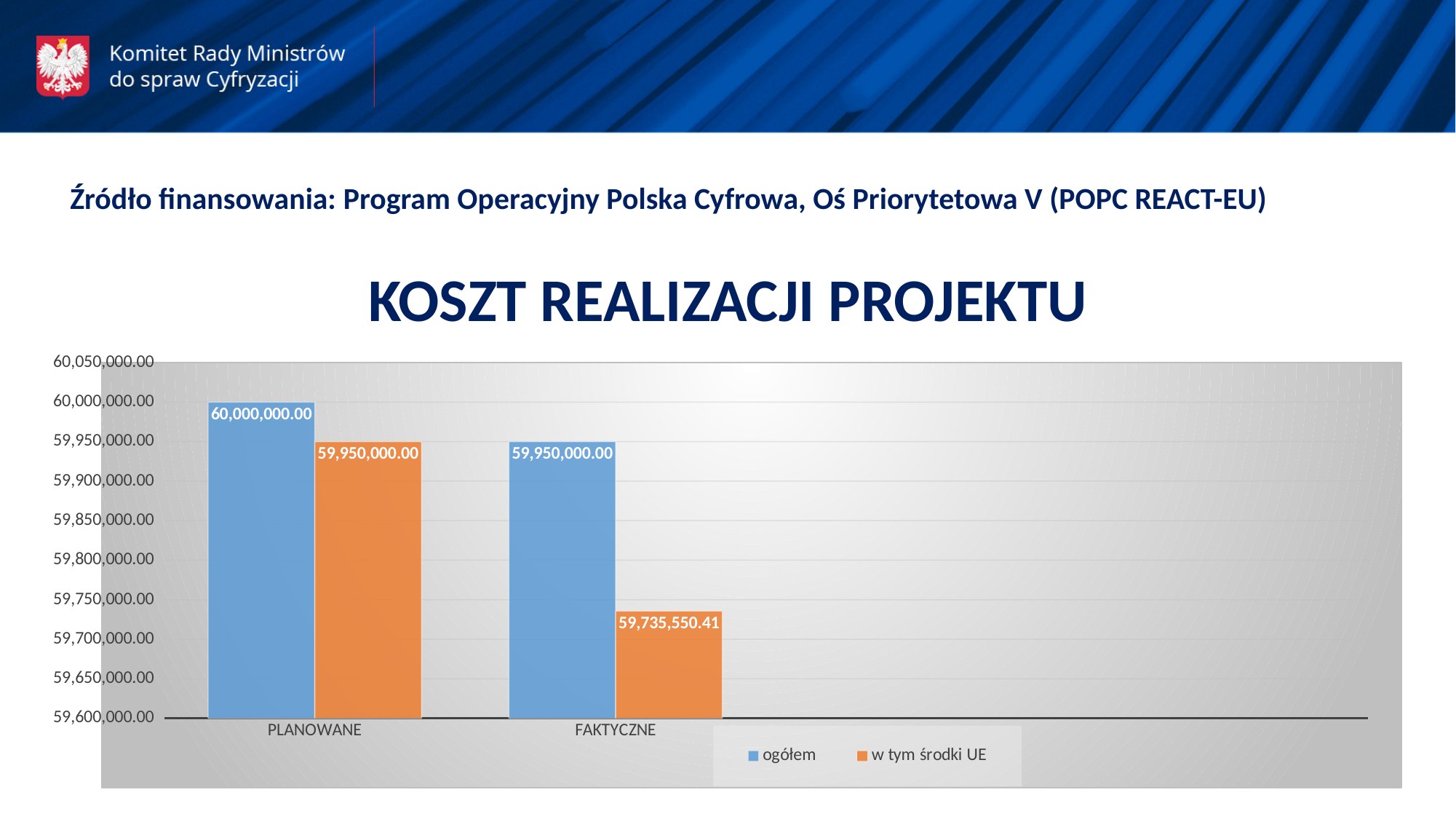
Which category has the lowest 'w tym środki UE' value? FAKTYCZNE Which category has the highest 'ogółem' value? PLANOWANE How many categories are shown on the x axis? 2 What is the difference between the 'ogółem' values for PLANOWANE and FAKTYCZNE? 50,000.00 What is the value of 'ogółem' for FAKTYCZNE? 59,950,000.00 What is the value of 'ogółem' for PLANOWANE? 60,000,000.00 What is the difference between 'ogółem' and 'w tym środki UE' for FAKTYCZNE? 214,449.59 What type of chart is shown on the slide? bar chart Is the 'w tym środki UE' value for PLANOWANE larger or smaller than the 'w tym środki UE' value for FAKTYCZNE? larger How many series does the legend list? 2 What is the value of 'w tym środki UE' for FAKTYCZNE? 59,735,550.41 What is the value of 'w tym środki UE' for PLANOWANE? 59,950,000.00